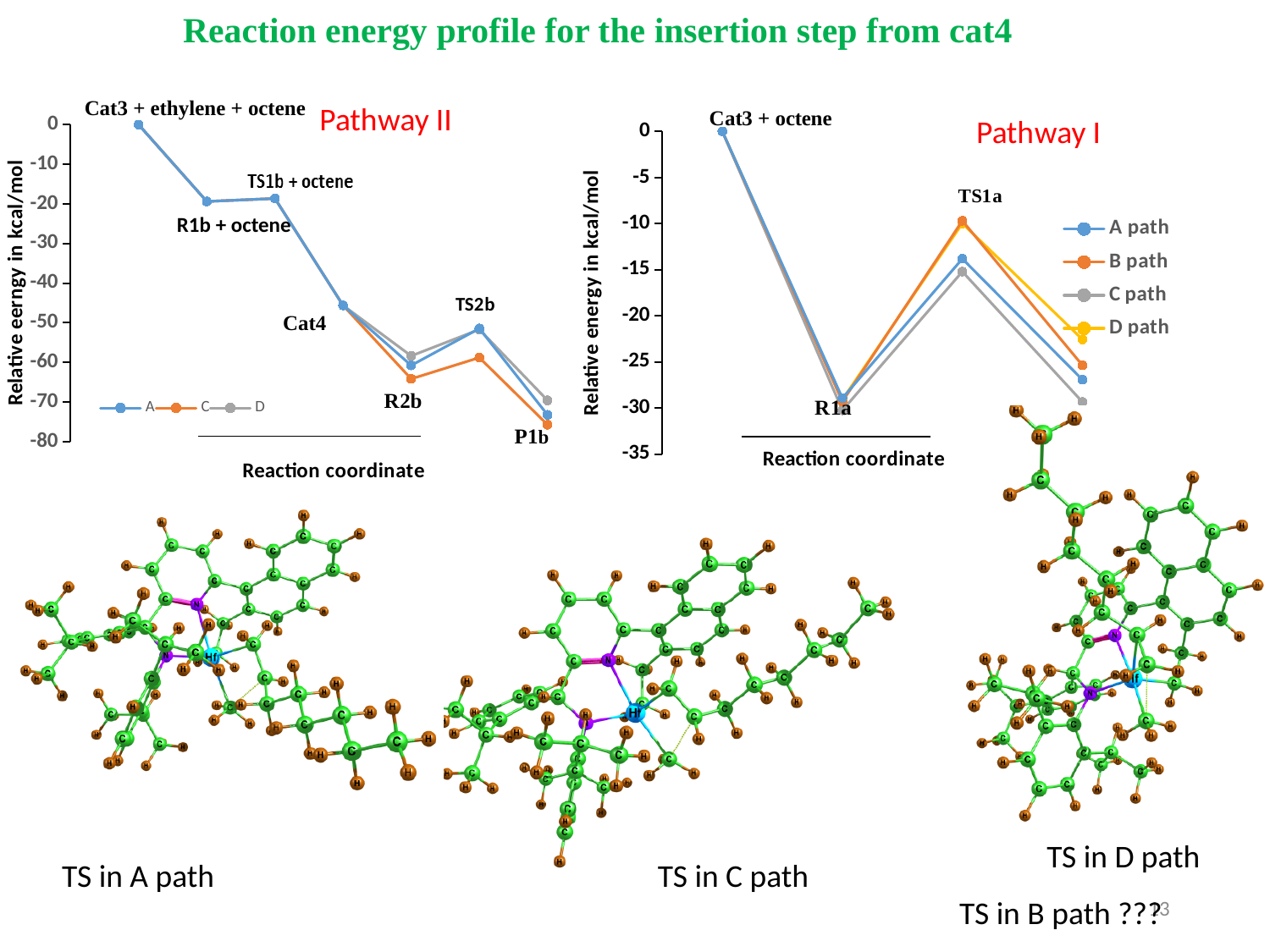
In the Pathway I chart, is the value for R1a greater or less than -25? less What kind of chart is the Pathway II chart? line chart How many series does the legend of the Pathway I chart list? 4 In the Pathway I chart, what is the relative energy of Cat3 + octene? 0 In the Pathway I chart, at TS1a, which is higher: B path or C path? B path In the Pathway II chart, what is the relative energy of Cat3 + ethylene + octene? 0 In the Pathway I chart, which path has the highest value at the final point after TS1a? D path How many series does the legend of the Pathway II chart list? 3 In the Pathway II chart, which series has the lowest value at R2b? C In the Pathway II chart, is the value for Cat4 greater or less than -40? less In the Pathway I chart, do the values rise or fall from Cat3 + octene to R1a? fall How many labeled points are there along the x axis of the Pathway II chart? 7